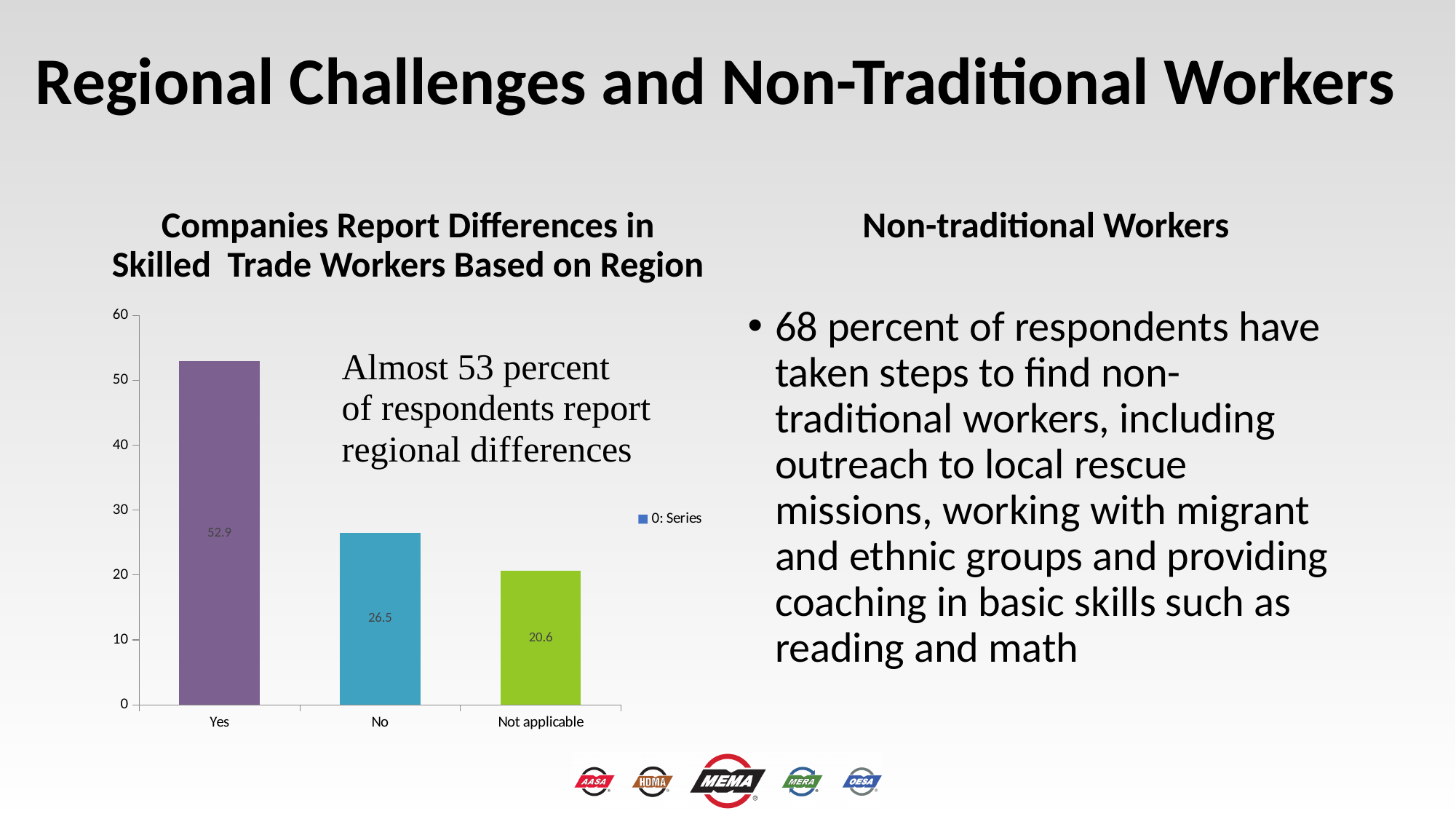
Which is larger, the value for No or the value for Not applicable? No What is the value for No? 26.5 Which category has the lowest value? Not applicable What is the difference between the values for No and Not applicable? 5.9 What kind of chart is shown on the slide? bar chart Is the value for Yes greater or less than 50? greater What is the value for Not applicable? 20.6 How many categories are shown on the x axis? 3 What is the value for Yes? 52.9 Which category has the highest value? Yes What is the difference between the values for Yes and No? 26.4 What is the title of the chart? Companies Report Differences in Skilled Trade Workers Based on Region